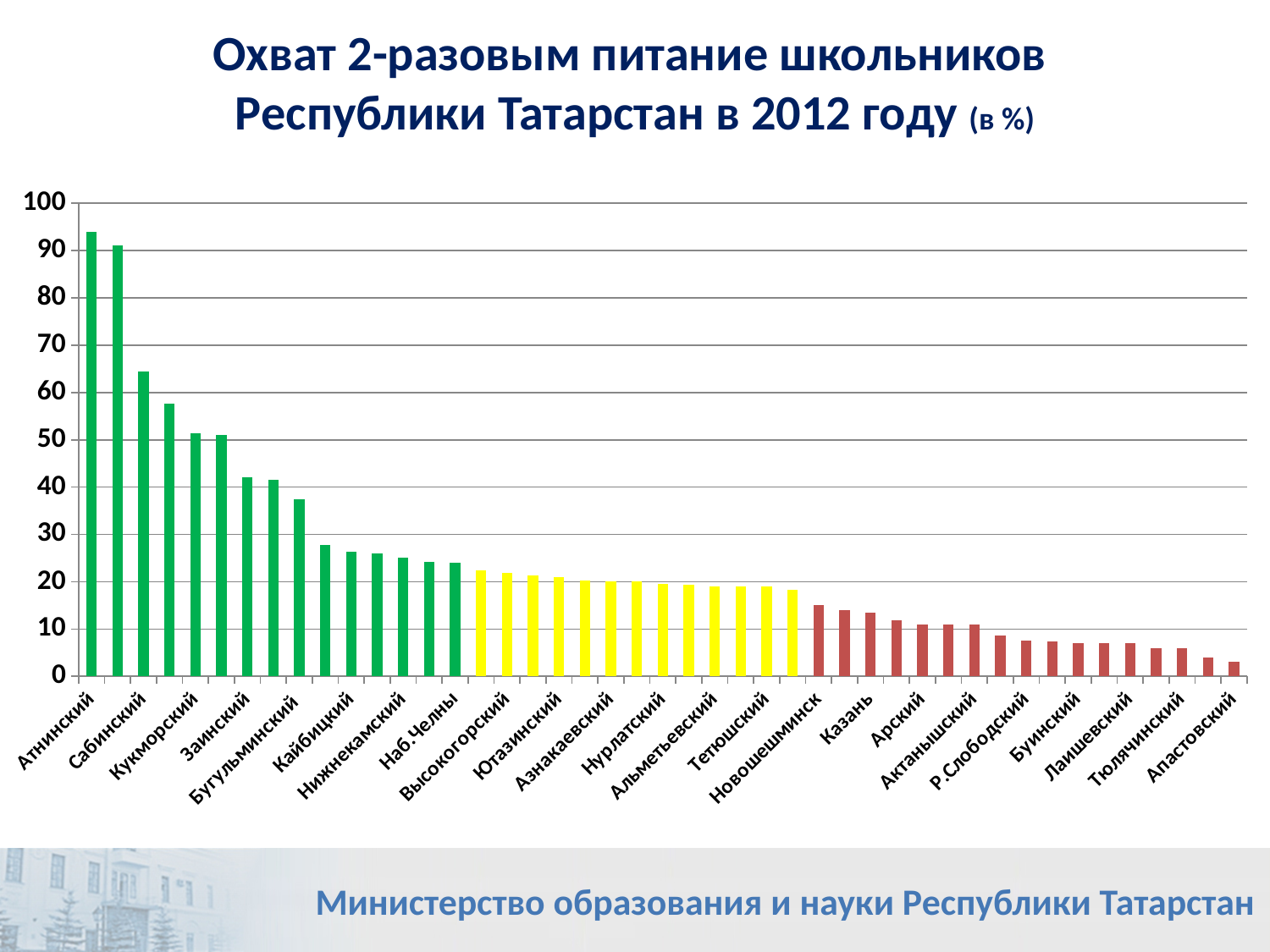
Which category has the highest value? Атнинский Is the value for Атнинский greater or less than 90? greater Is the value for Апастовский greater or less than 10? less Is the value for Высокогорский greater or less than 30? less Which is larger, the value for Сабинский or the value for Казань? Сабинский What kind of chart is shown on the slide? bar chart Which category has the lowest value? Апастовский Which is larger, the value for Атнинский or the value for Апастовский? Атнинский What colour are the bars with the highest values on the left of the chart? green Do the values rise or fall from left to right along the x axis? fall